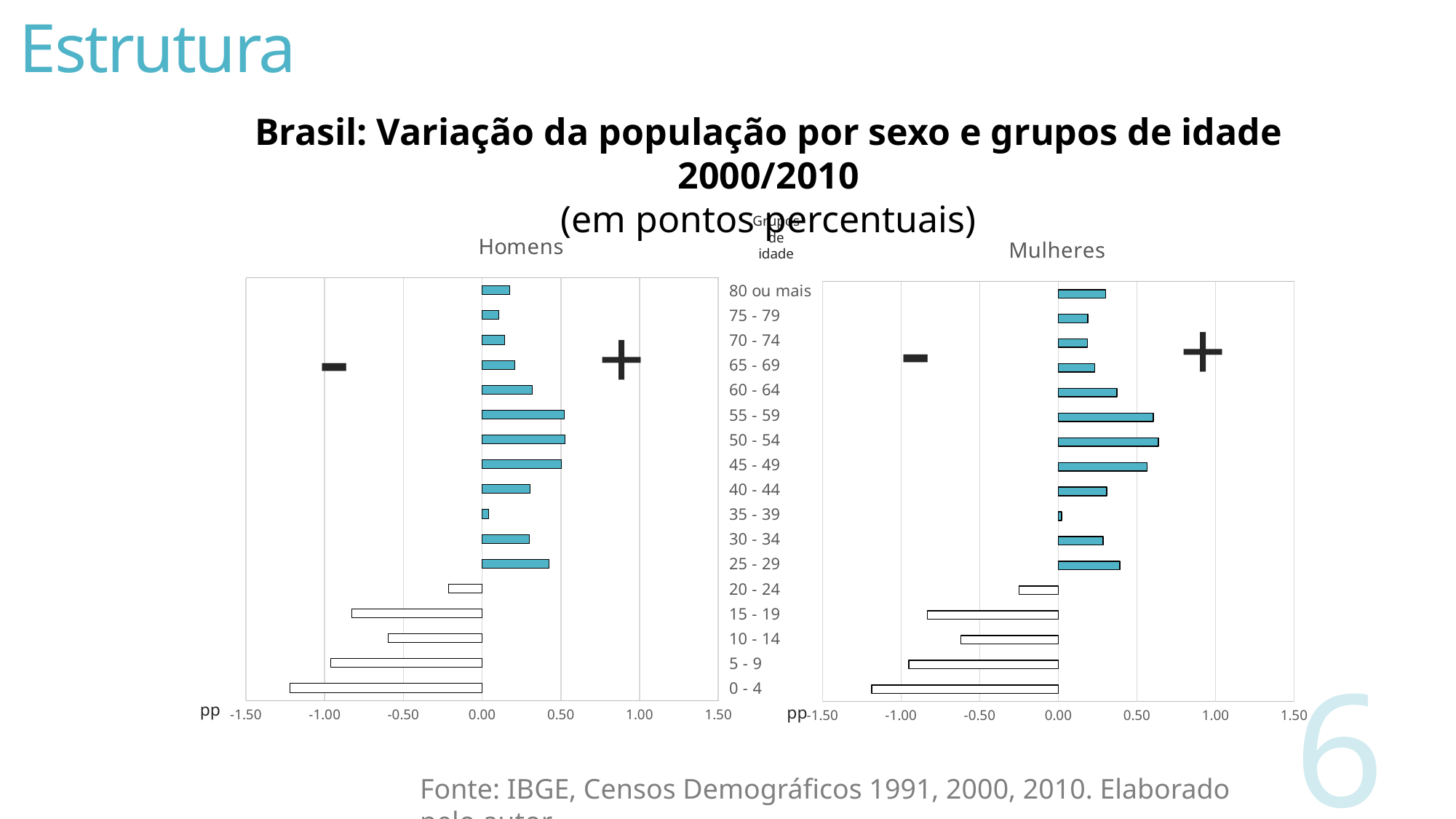
What kind of chart is the Homens chart? bar chart In the Mulheres chart, is the value for 50 - 54 greater or less than 0.50? greater In the Homens chart, which age group has the lowest value? 0 - 4 In the Mulheres chart, which age group has the lowest value? 0 - 4 What unit label is shown at the left end of the horizontal axis of each chart? pp What is the title of the chart on the right side of the slide? Mulheres How many age groups are plotted in the Mulheres chart? 17 In the Homens chart, which is larger, the value for 25 - 29 or the value for 20 - 24? 25 - 29 In the Homens chart, is the value for 15 - 19 greater or less than -1.00? greater In the Homens chart, is the value for 0 - 4 greater or less than -1.00? less In the Mulheres chart, which is larger, the value for 10 - 14 or the value for 15 - 19? 10 - 14